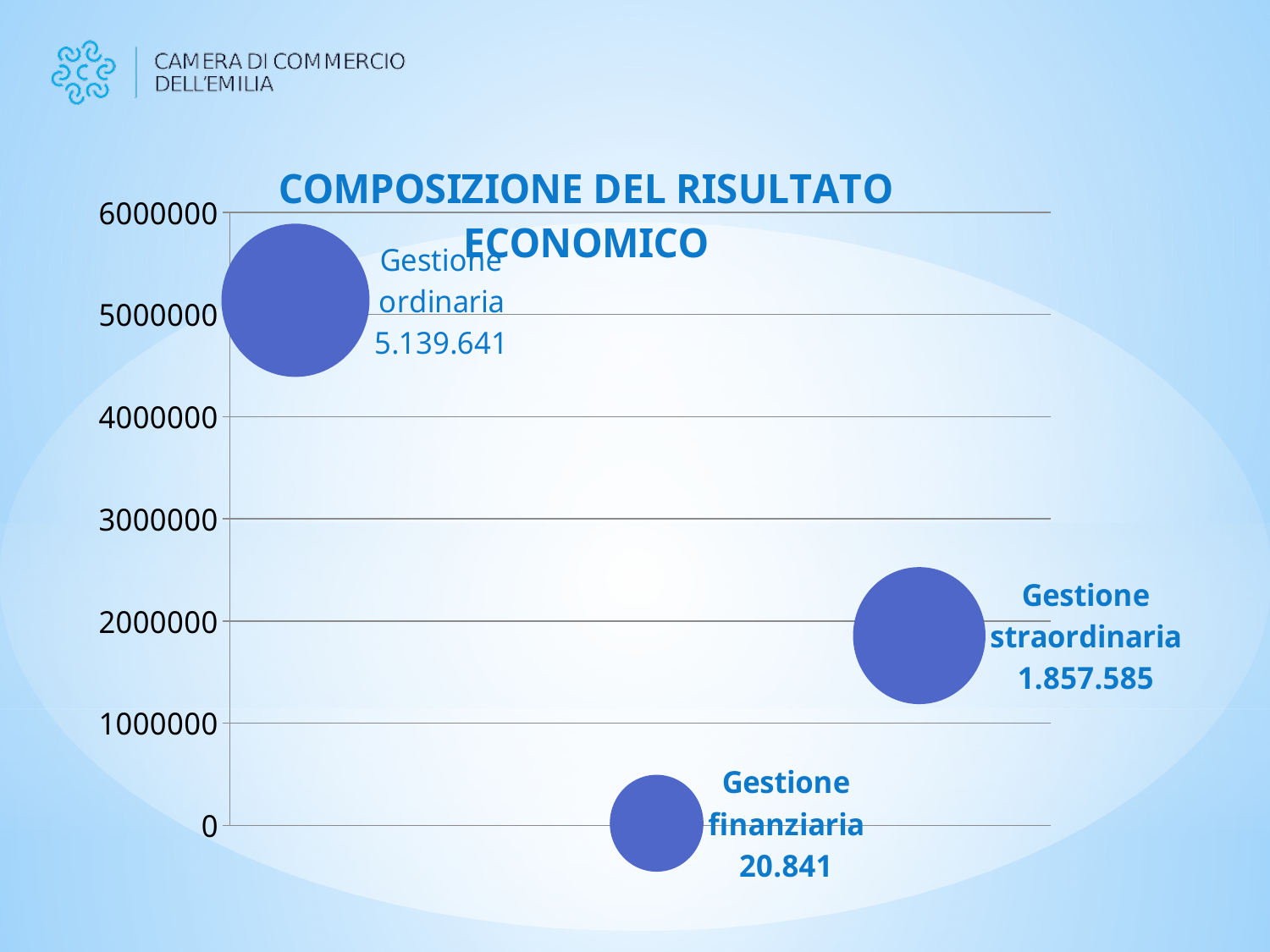
What is the difference between the values for Gestione straordinaria and Gestione finanziaria? 1.836.744 What is the value for Gestione ordinaria? 5.139.641 Is the value for Gestione ordinaria greater or less than 4000000? greater What is the title of the chart? COMPOSIZIONE DEL RISULTATO ECONOMICO What is the difference between the values for Gestione ordinaria and Gestione straordinaria? 3.282.056 What kind of chart is shown on the slide? Bubble chart Which is larger, the value for Gestione straordinaria or the value for Gestione finanziaria? Gestione straordinaria How many data points are plotted on the chart? 3 Which category has the lowest value? Gestione finanziaria Which category has the highest value? Gestione ordinaria What is the value for Gestione finanziaria? 20.841 What is the value for Gestione straordinaria? 1.857.585